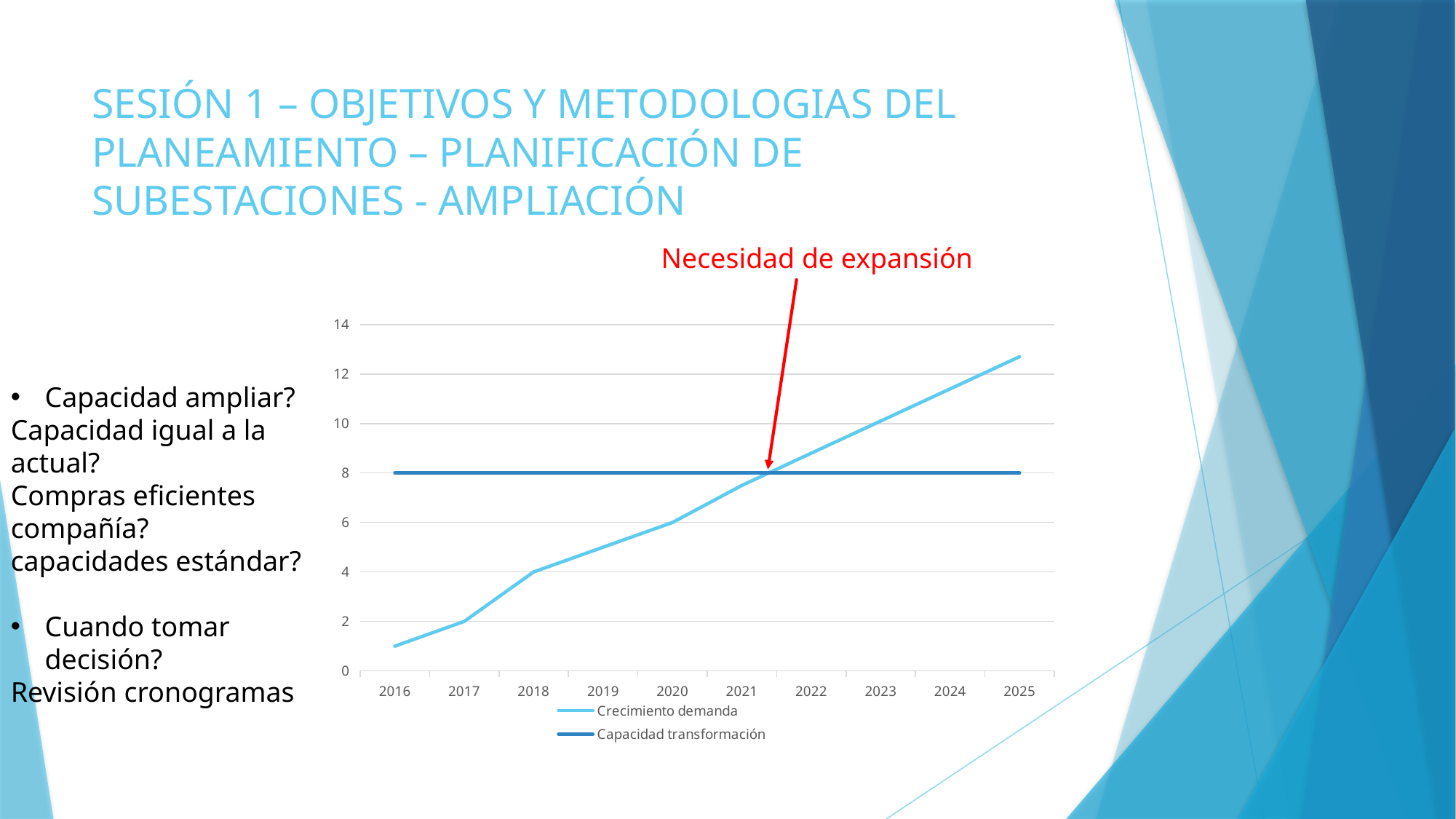
Is the value of Crecimiento demanda in 2025 greater or less than 12? greater Does the Crecimiento demanda line rise or fall from 2016 to 2025? rises In 2018, which series has the larger value, Crecimiento demanda or Capacidad transformación? Capacidad transformación What is the value of Capacidad transformación in 2020? 8 In which year is Crecimiento demanda at its highest? 2025 Is the value of Crecimiento demanda in 2016 greater or less than 2? less How many series does the chart legend list? 2 How many years are shown on the x axis of the chart? 10 What kind of chart is shown on the slide? line chart In 2025, which series has the larger value, Crecimiento demanda or Capacidad transformación? Crecimiento demanda What text does the red annotation above the chart say? Necesidad de expansión